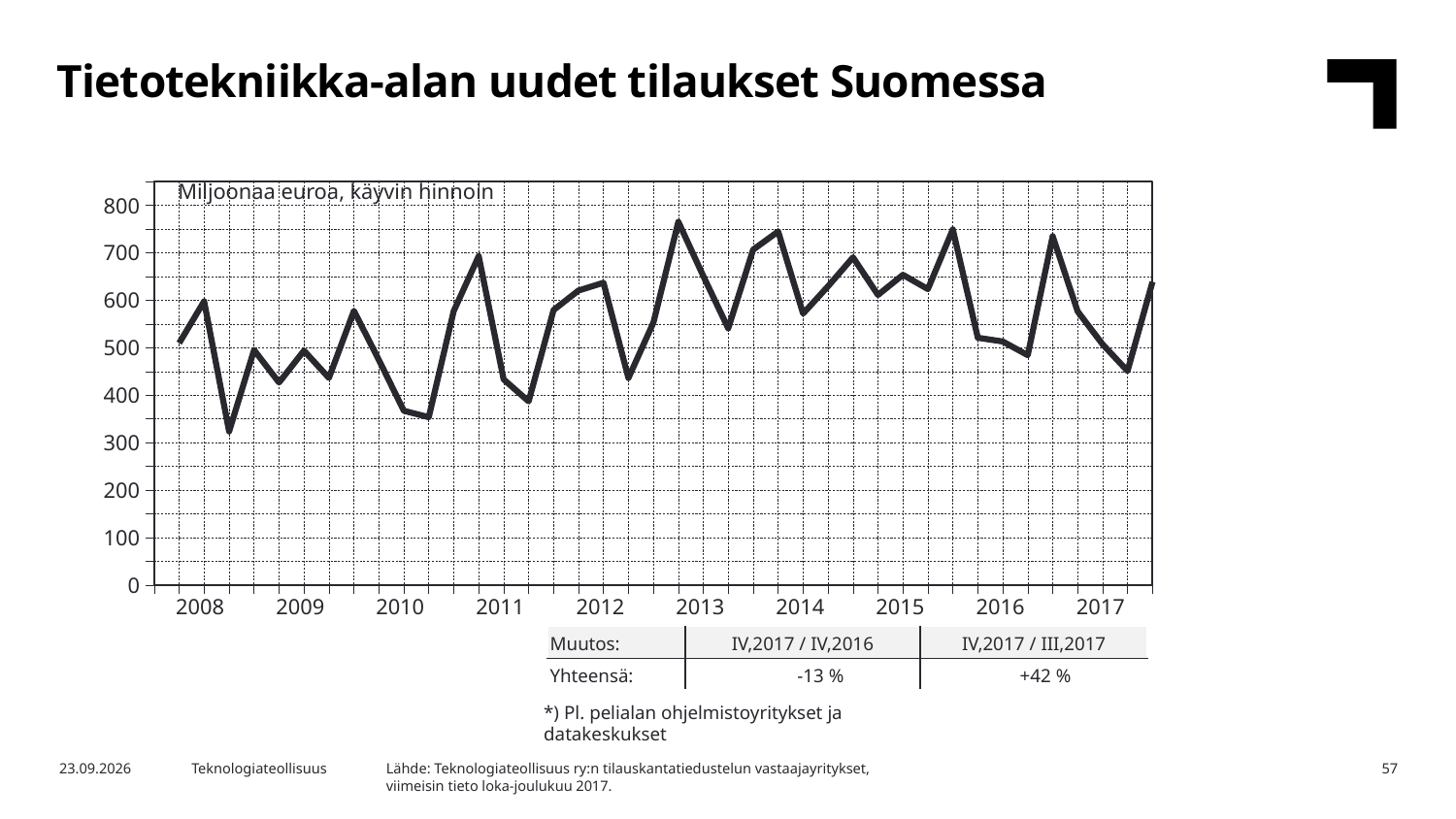
Is the low point of the line in 2010 greater or less than 400? less What is the highest value shown on the y axis? 800 Is the lowest point of the line (in 2008) greater or less than 400? less What unit label is printed inside the chart area? Miljoonaa euroa, käyvin hinnoin Is the last point of the line (end of 2017) greater or less than 600? greater Does the line rise or fall from the low point in 2017 to the final point? rise How many year labels are shown on the x axis? 10 What is the title of the slide's chart? Tietotekniikka-alan uudet tilaukset Suomessa What kind of chart is shown on the slide? line chart Does the line rise or fall from its 2016 peak to the low point in 2017? fall